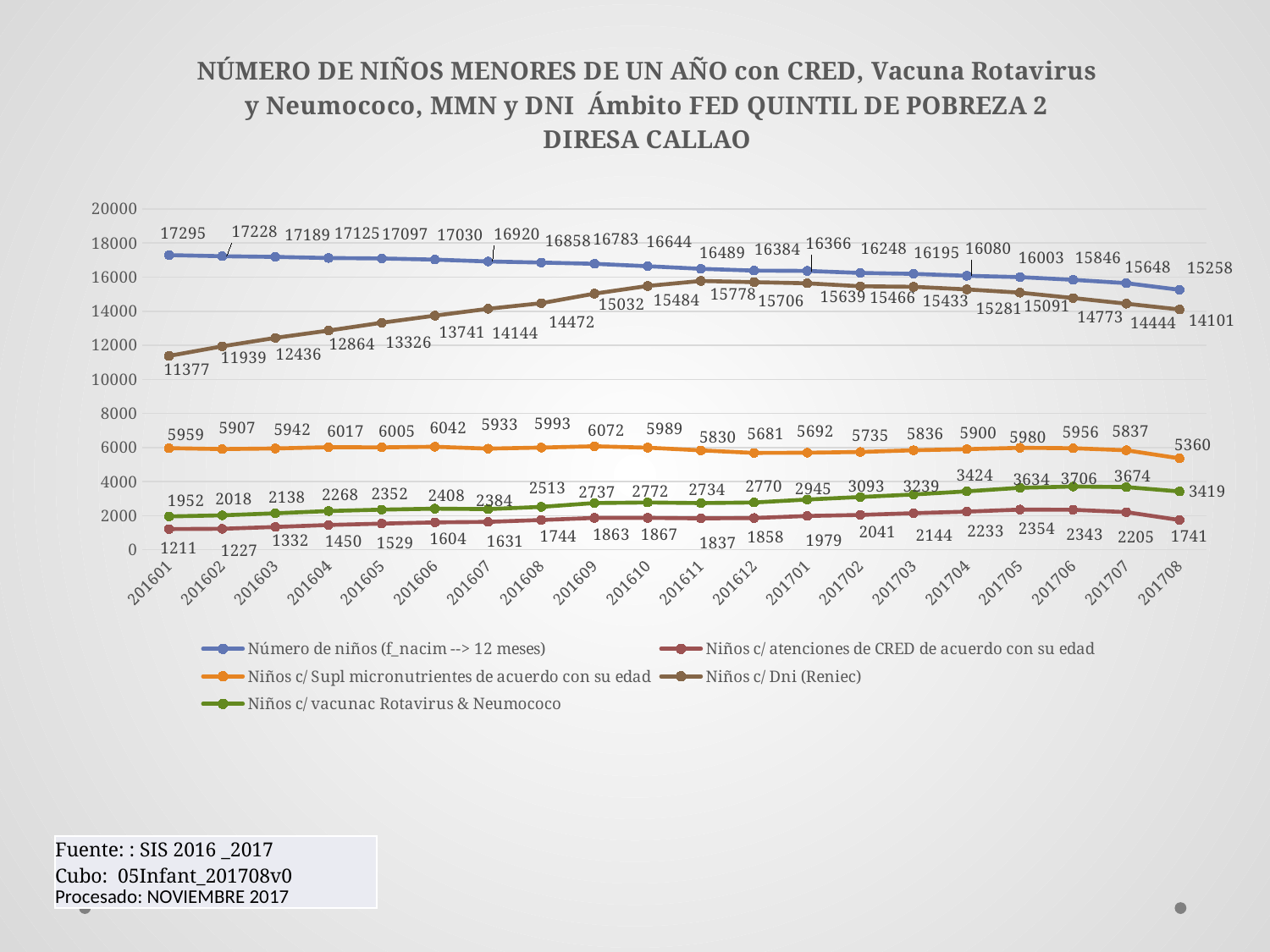
What is the difference between 'Número de niños (f_nacim --> 12 meses)' and 'Niños c/ Dni (Reniec)' in 201601? 5918 Which is larger in 201708: 'Niños c/ Supl micronutrientes de acuerdo con su edad' or 'Niños c/ vacunac Rotavirus & Neumococo'? Niños c/ Supl micronutrientes de acuerdo con su edad What is the value of 'Niños c/ vacunac Rotavirus & Neumococo' for 201706? 3706 What is the value of 'Número de niños (f_nacim --> 12 meses)' for 201601? 17295 What is the value of 'Niños c/ Dni (Reniec)' for 201708? 14101 In which period is 'Niños c/ atenciones de CRED de acuerdo con su edad' lowest? 201601 How many series does the legend list? 5 What type of chart is shown on the slide? Line chart Does 'Número de niños (f_nacim --> 12 meses)' rise or fall from 201601 to 201708? Fall How many time periods are plotted along the x axis? 20 Which colour is used for the 'Niños c/ Dni (Reniec)' line? Brown In which period does 'Niños c/ Dni (Reniec)' reach its highest value? 201611